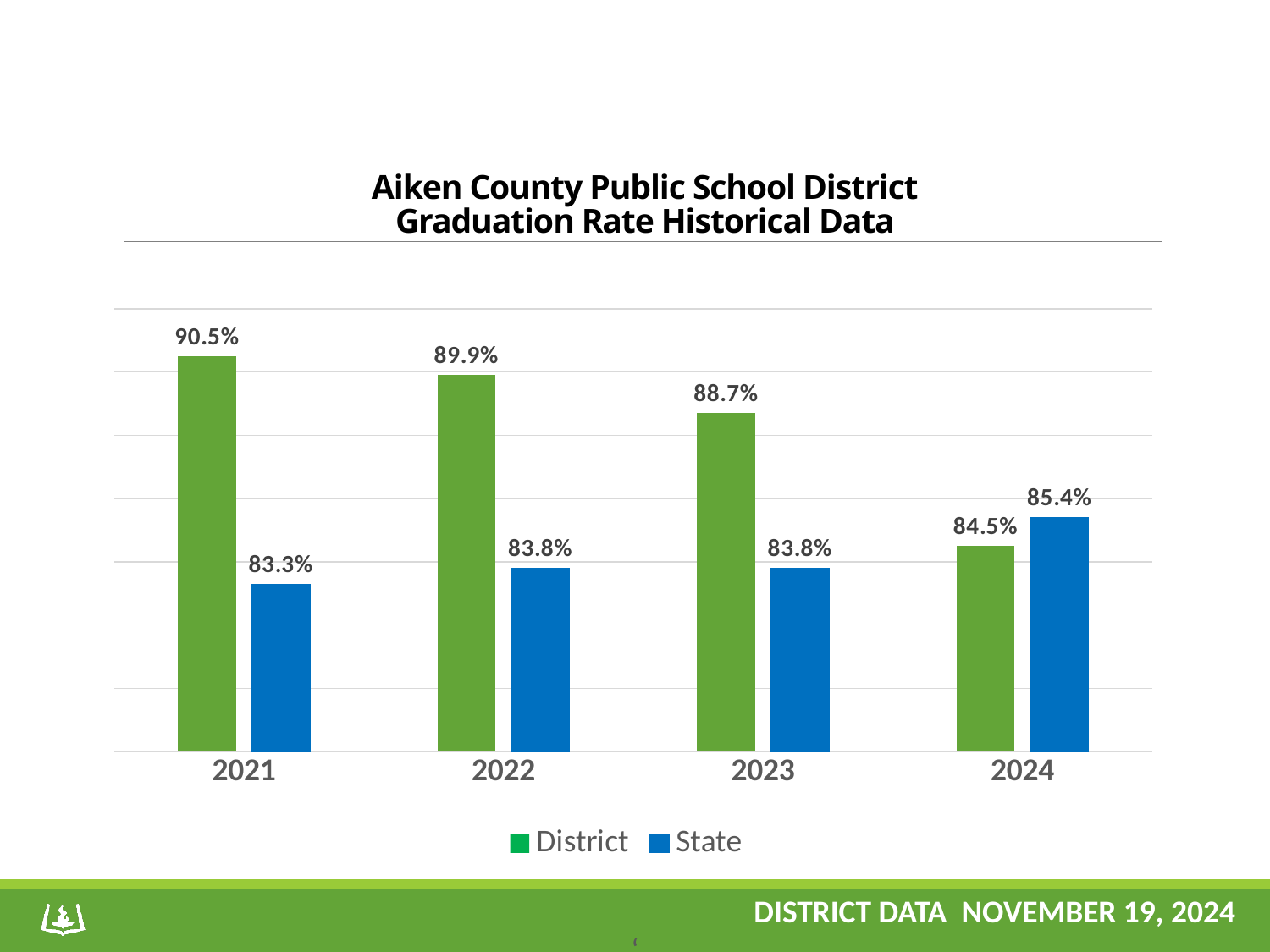
What was the District graduation rate in 2023? 88.7% Which was higher in 2022, the District or the State graduation rate? District In which year was the District graduation rate lowest? 2024 What was the State graduation rate in 2024? 85.4% What was the District graduation rate in 2021? 90.5% What kind of chart is shown on the slide? Bar chart How many years are shown on the x axis? 4 Which was higher in 2024, the District or the State graduation rate? State How many series does the legend list? 2 What is the difference between the District and State graduation rates in 2021? 7.2% Does the District graduation rate rise or fall from 2021 to 2024? Fall In which year was the District graduation rate highest? 2021